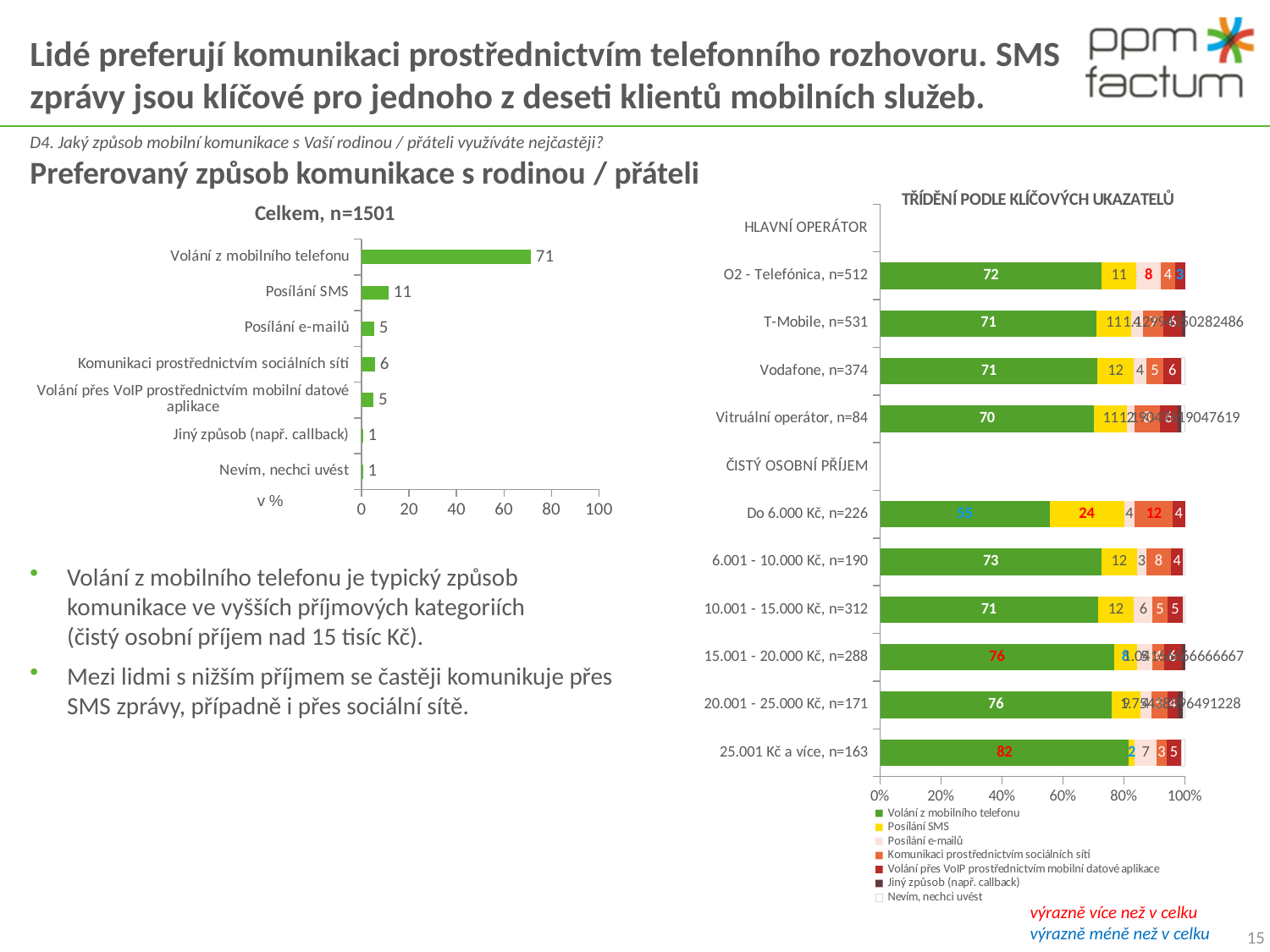
In the 'TŘÍDĚNÍ PODLE KLÍČOVÝCH UKAZATELŮ' chart, what is the value of 'Posílání SMS' for 'Do 6.000 Kč, n=226'? 24 In the 'Celkem, n=1501' chart, which category has the highest value? Volání z mobilního telefonu What kind of chart is the 'Celkem, n=1501' chart? bar chart In the 'TŘÍDĚNÍ PODLE KLÍČOVÝCH UKAZATELŮ' chart, what is the difference in 'Volání z mobilního telefonu' between '25.001 Kč a více, n=163' and 'Do 6.000 Kč, n=226'? 27 In the 'TŘÍDĚNÍ PODLE KLÍČOVÝCH UKAZATELŮ' chart, what is the value of 'Volání z mobilního telefonu' for 'O2 - Telefónica, n=512'? 72 In the 'Celkem, n=1501' chart, what is the value for 'Volání z mobilního telefonu'? 71 How many series does the legend of the 'TŘÍDĚNÍ PODLE KLÍČOVÝCH UKAZATELŮ' chart list? 7 In the 'Celkem, n=1501' chart, what is the difference between 'Volání z mobilního telefonu' and 'Posílání SMS'? 60 How many categories are shown in the 'Celkem, n=1501' chart? 7 In the 'Celkem, n=1501' chart, which is larger: 'Posílání e-mailů' or 'Komunikaci prostřednictvím sociálních sítí'? Komunikaci prostřednictvím sociálních sítí In the 'TŘÍDĚNÍ PODLE KLÍČOVÝCH UKAZATELŮ' chart, which income group has the highest value for 'Volání z mobilního telefonu'? 25.001 Kč a více, n=163 In the 'Celkem, n=1501' chart, what is the value for 'Posílání SMS'? 11